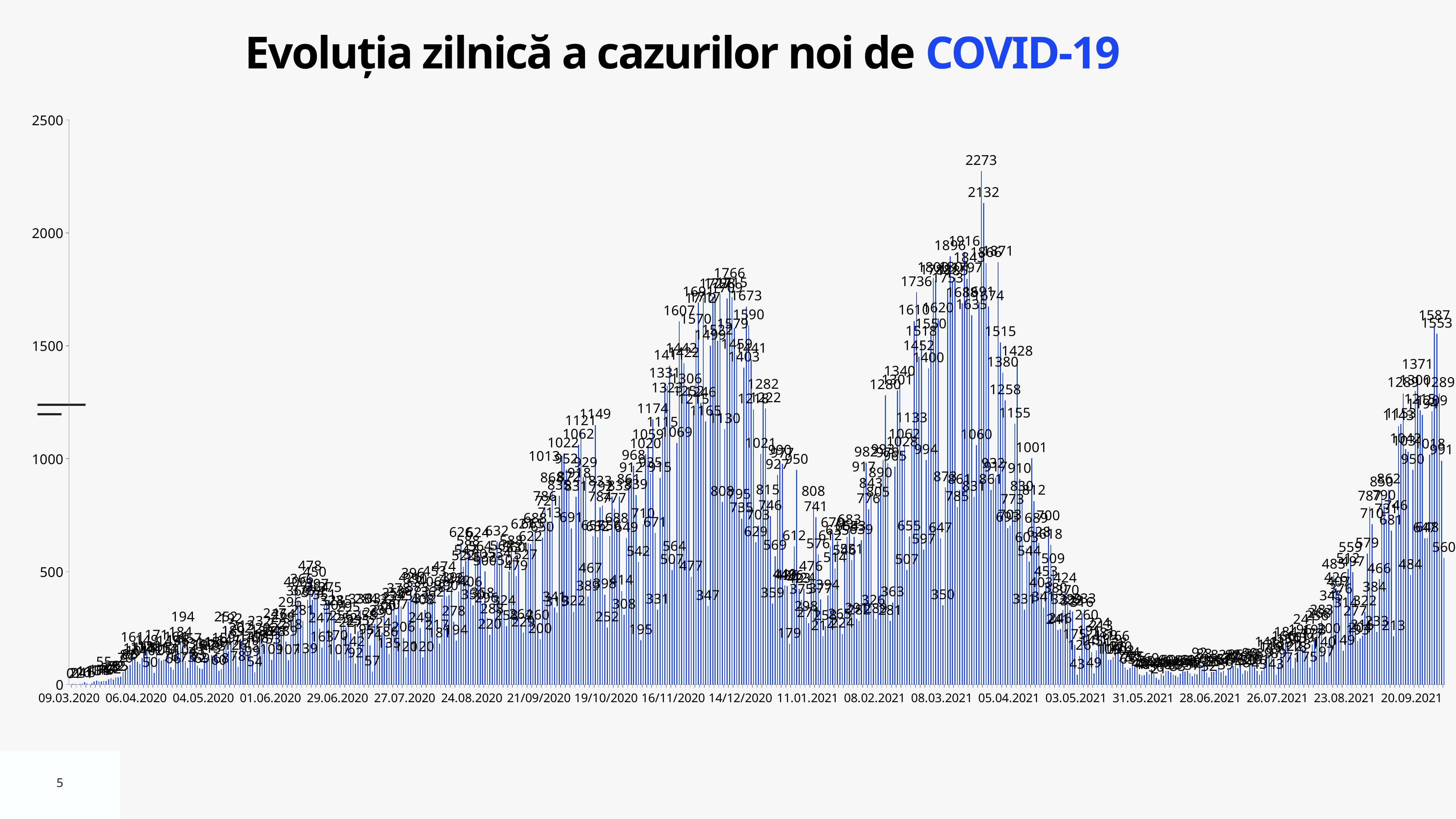
What kind of chart is shown on the slide? bar chart What is the highest value labelled in the final wave near 20.09.2021? 1587 Are the daily values around 31.05.2021 greater or less than 500? less What is the difference between the two highest labelled values, 2273 and 2132? 141 What is the second-highest daily value labelled on the chart, just below the 2273 peak? 2132 What is the highest daily value labelled on the chart? 2273 Which is larger: the peak of the wave around 05.04.2021 or the peak of the wave around 14.12.2020? the peak around 05.04.2021 Do the daily values rise or fall between 26.07.2021 and 20.09.2021? rise What is the title of the chart on the slide? Evoluția zilnică a cazurilor noi de COVID-19 Do the daily values rise or fall between 05.04.2021 and 31.05.2021? fall What is the topmost tick value on the vertical axis? 2500 Is the highest bar on the chart greater or less than 2000? greater